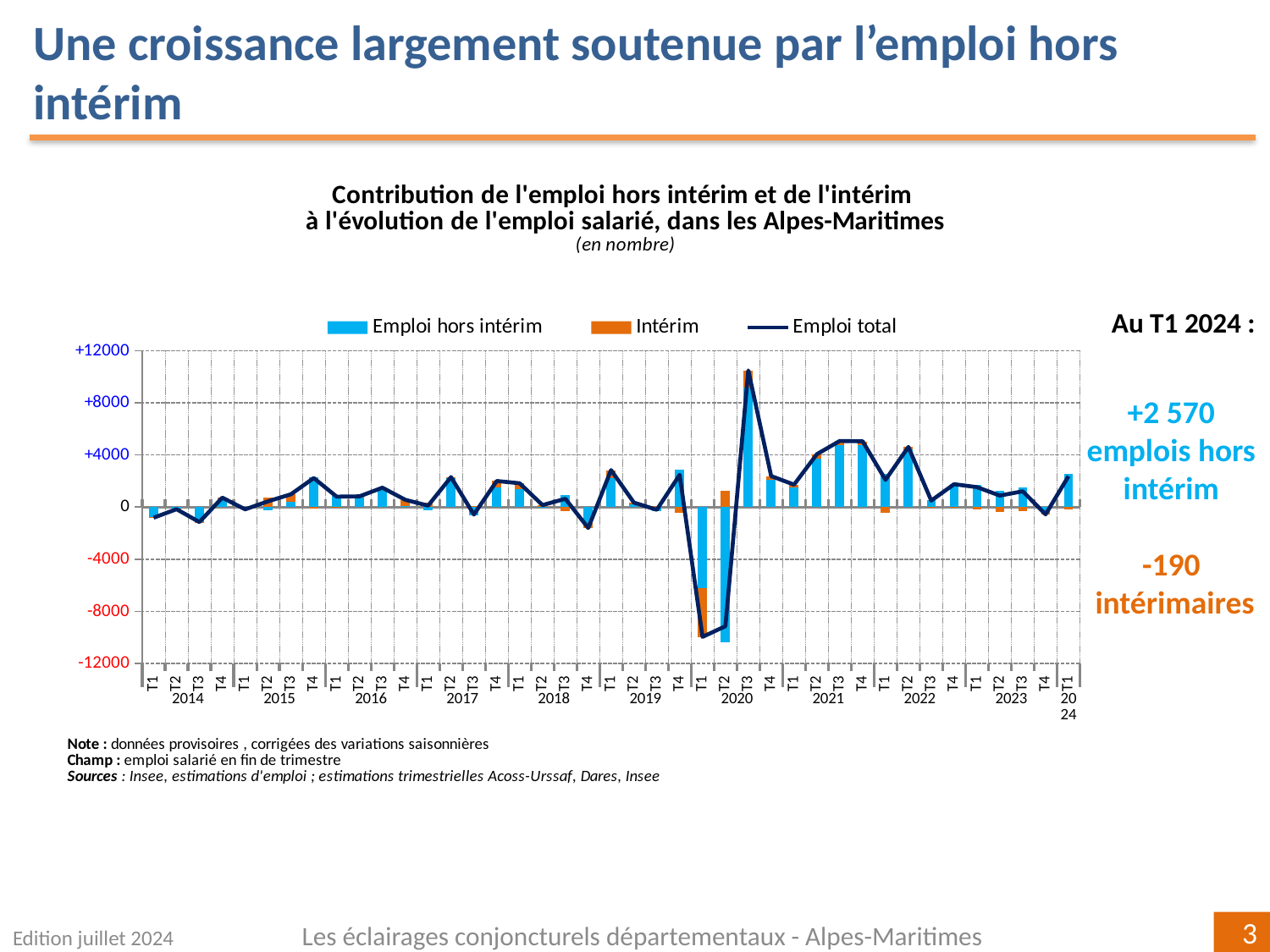
Which colour represents the Intérim series in the chart? Orange Which is larger, the Emploi hors intérim value for T3 2021 or for T1 2021? T3 2021 In which quarter is the Emploi hors intérim bar the lowest? T2 2020 Does the Emploi total line rise or fall from T1 2021 to T3 2021? rise Is the Emploi hors intérim value for T3 2021 greater or less than 4000? greater What kind of chart is shown on the slide? A combined bar and line chart What is the total of the Emploi hors intérim and Intérim contributions at T1 2024, using the annotated values? 2 380 Is the Emploi hors intérim value for T3 2020 greater or less than 8000? greater How many series does the chart legend list? 3 In which quarter is the Emploi hors intérim bar the highest? T3 2020 According to the annotation, what is the value for Emploi hors intérim at T1 2024? +2 570 According to the annotation, what is the value for Intérim at T1 2024? -190